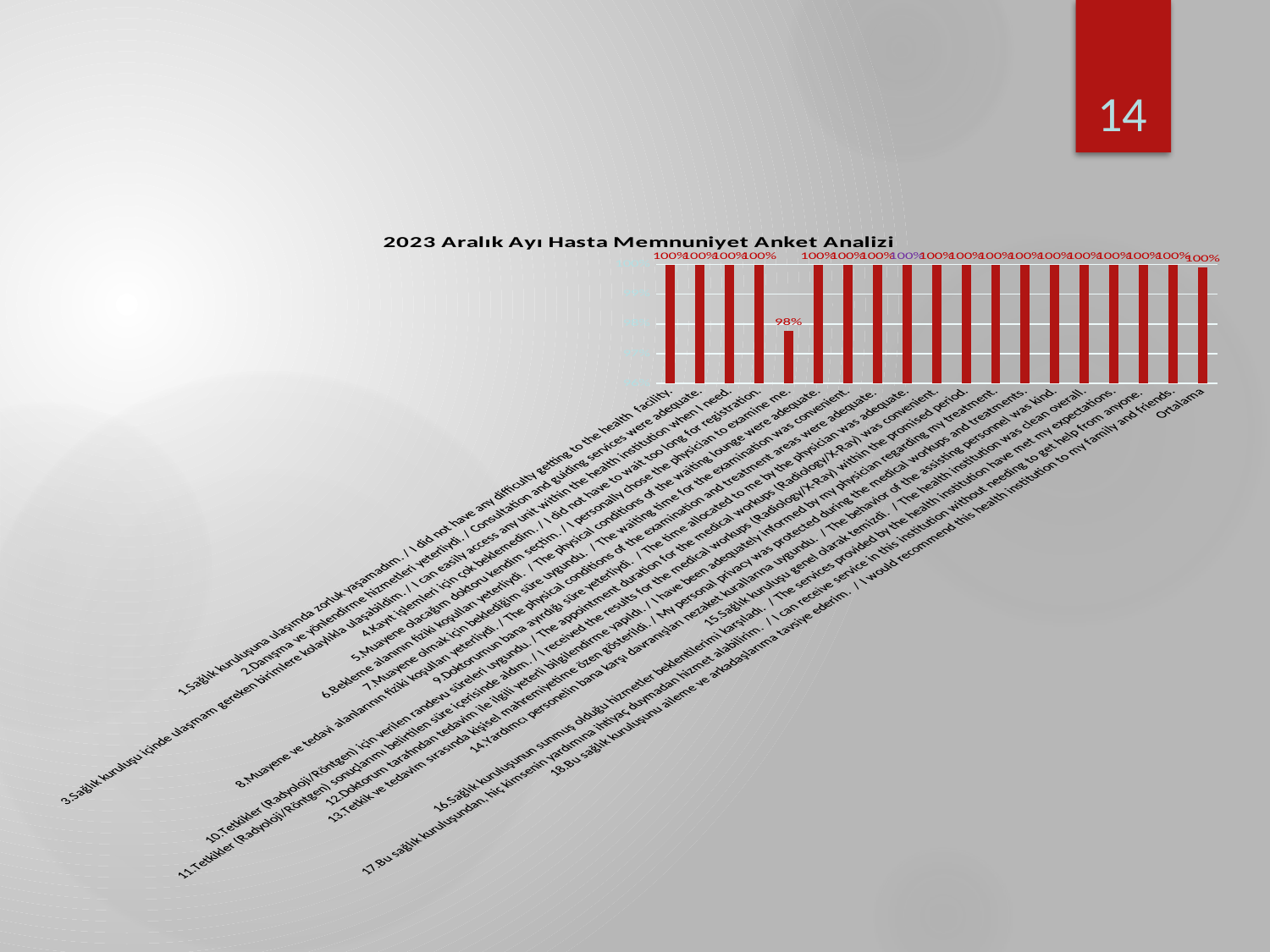
Which category has the lowest value in the chart? 5.Muayene olacağım doktoru kendim seçtim. / I personally chose the physician to examine me. Which is larger: the value for "4.Kayıt işlemleri için çok beklemedim." or the value for "5.Muayene olacağım doktoru kendim seçtim."? 4.Kayıt işlemleri için çok beklemedim. What kind of chart is shown on the slide? Bar chart What is the value shown for "18.Bu sağlık kuruluşunu aileme ve arkadaşlarıma tavsiye ederim. / I would recommend this health institution to my family and friends."? 100% What is the value shown for "5.Muayene olacağım doktoru kendim seçtim. / I personally chose the physician to examine me."? 98% How many bars in the chart have a value of 100%? 18 What is the difference between the value for "Ortalama" and the value for "5.Muayene olacağım doktoru kendim seçtim."? 2% What colour are the bars in the chart? Red What is the title of the chart? 2023 Aralık Ayı Hasta Memnuniyet Anket Analizi How many bars are plotted in the chart? 19 What is the value shown for "Ortalama"? 100% What is the value shown for "1.Sağlık kuruluşuna ulaşımda zorluk yaşamadım. / I did not have any difficulty getting to the health facility."? 100%